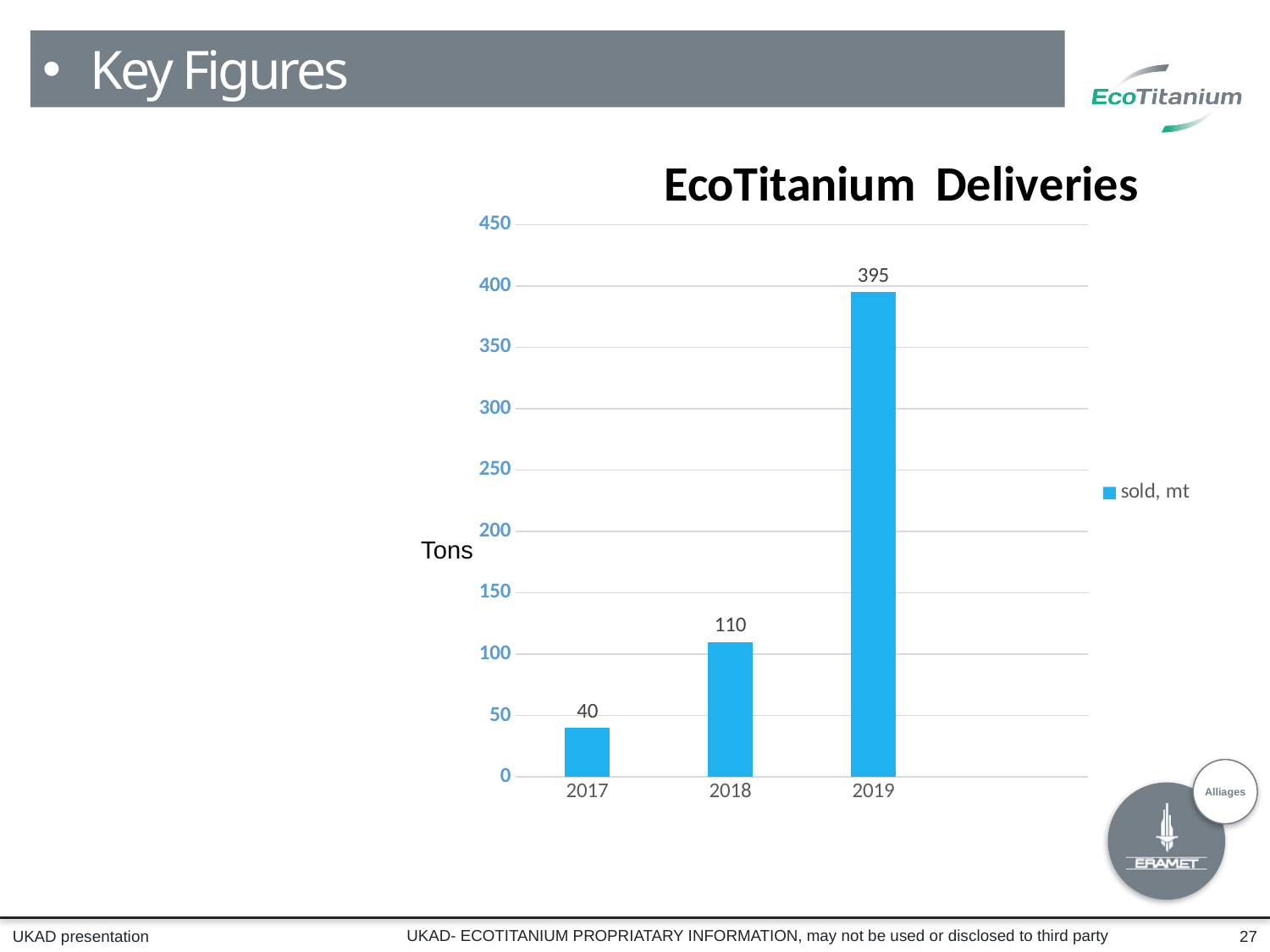
What is the value for 2017 in the EcoTitanium Deliveries chart? 40 What is the difference between the 2019 and 2018 values in the chart? 285 Which year has the lowest deliveries in the chart? 2017 What is the value for 2018 in the EcoTitanium Deliveries chart? 110 What kind of chart is shown on the slide? bar chart Which year has the highest deliveries in the chart? 2019 How many years are shown on the x axis of the chart? 3 Do the values rise or fall from 2017 to 2019? rise Which is larger, the value for 2018 or the value for 2017? 2018 Is the value for 2019 greater or less than 350? greater What is the difference between the 2018 and 2017 values in the chart? 70 What is the value for 2019 in the EcoTitanium Deliveries chart? 395